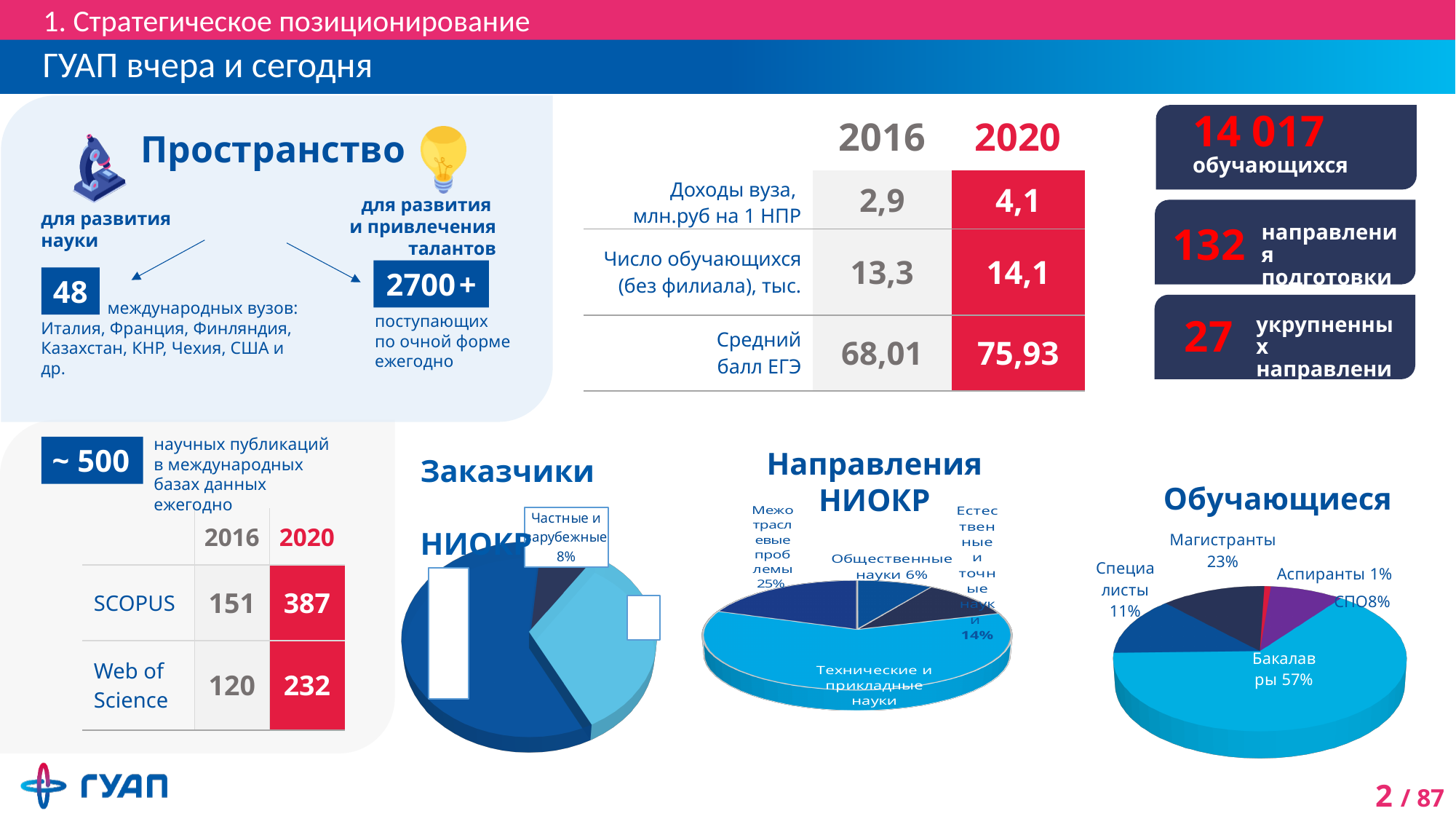
In the 'Обучающиеся' pie chart, which category has the largest share? Бакалавры In the 'Направления НИОКР' pie chart, what share do Межотраслевые проблемы have? 25% In the 'Направления НИОКР' pie chart, what is the difference between the shares of Межотраслевые проблемы and Общественные науки? 19% In the 'Заказчики НИОКР' chart, what share do Частные и зарубежные have? 8% In the 'Направления НИОКР' pie chart, what share do Естественные и точные науки have? 14% In the 'Обучающиеся' pie chart, what share do Магистранты have? 23% In the 'Обучающиеся' pie chart, which is larger: СПО or Специалисты? Специалисты How many categories does the 'Обучающиеся' pie chart show? 5 In the 'Направления НИОКР' pie chart, which category has the largest slice? Технические и прикладные науки In the 'Обучающиеся' pie chart, what share do Бакалавры have? 57% In the 'Обучающиеся' pie chart, which category has the smallest share? Аспиранты In the 'Обучающиеся' pie chart, what is the difference between the shares of Магистранты and Специалисты? 12%